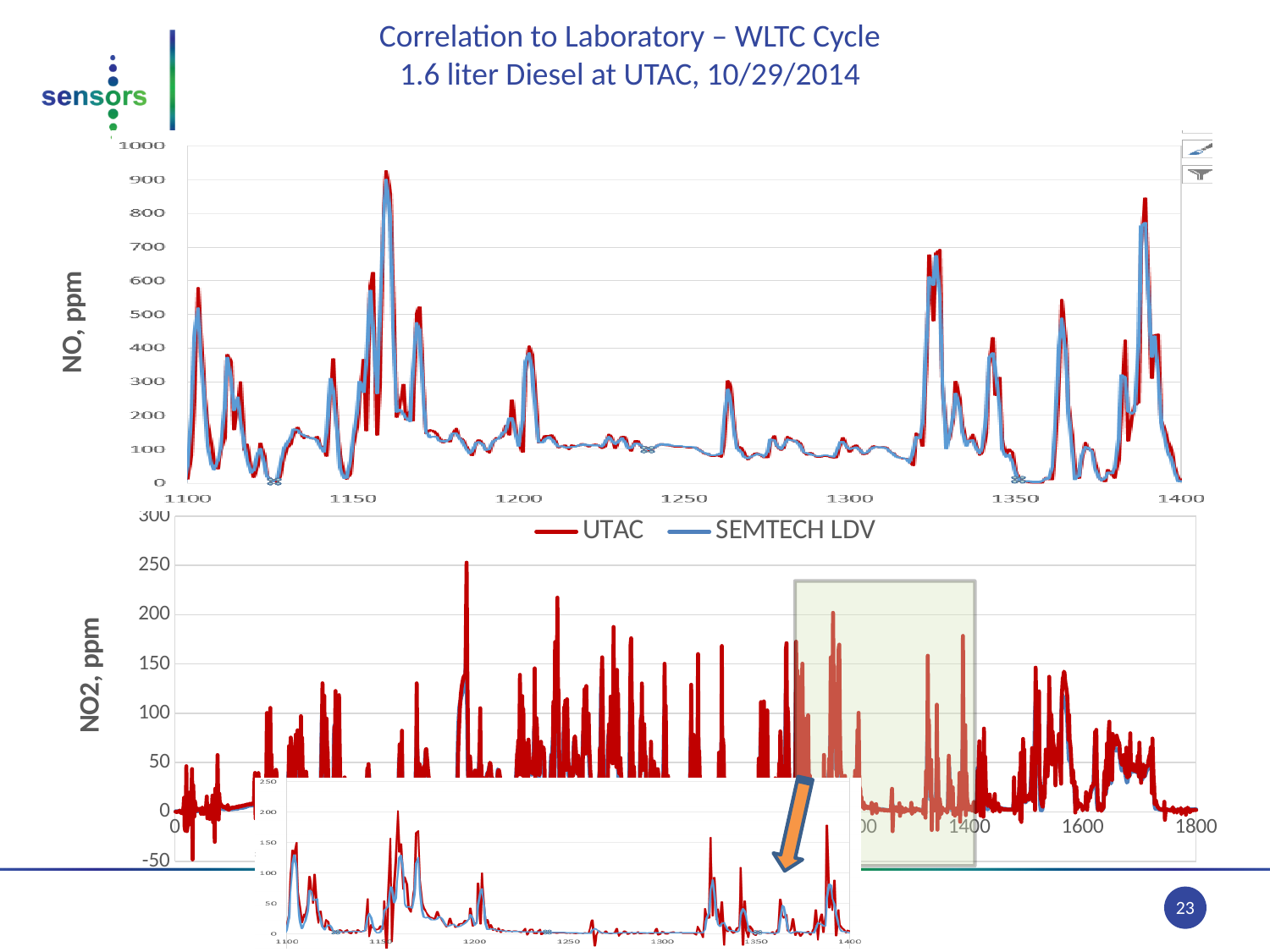
What is the y-axis label of the bottom chart? NO2, ppm How many series does the legend list? 2 In the top NO chart, is the UTAC value at about x = 1355 greater or less than 100? less What kind of chart is the top chart labelled NO, ppm? line chart What are the two series named in the legend? UTAC and SEMTECH LDV What is the maximum value shown on the y-axis of the top NO chart? 1000 In the top NO chart, is the highest peak of the UTAC series (near x = 1160) greater or less than 800? greater In the top NO chart, is the peak near x = 1390 greater or less than 700? greater